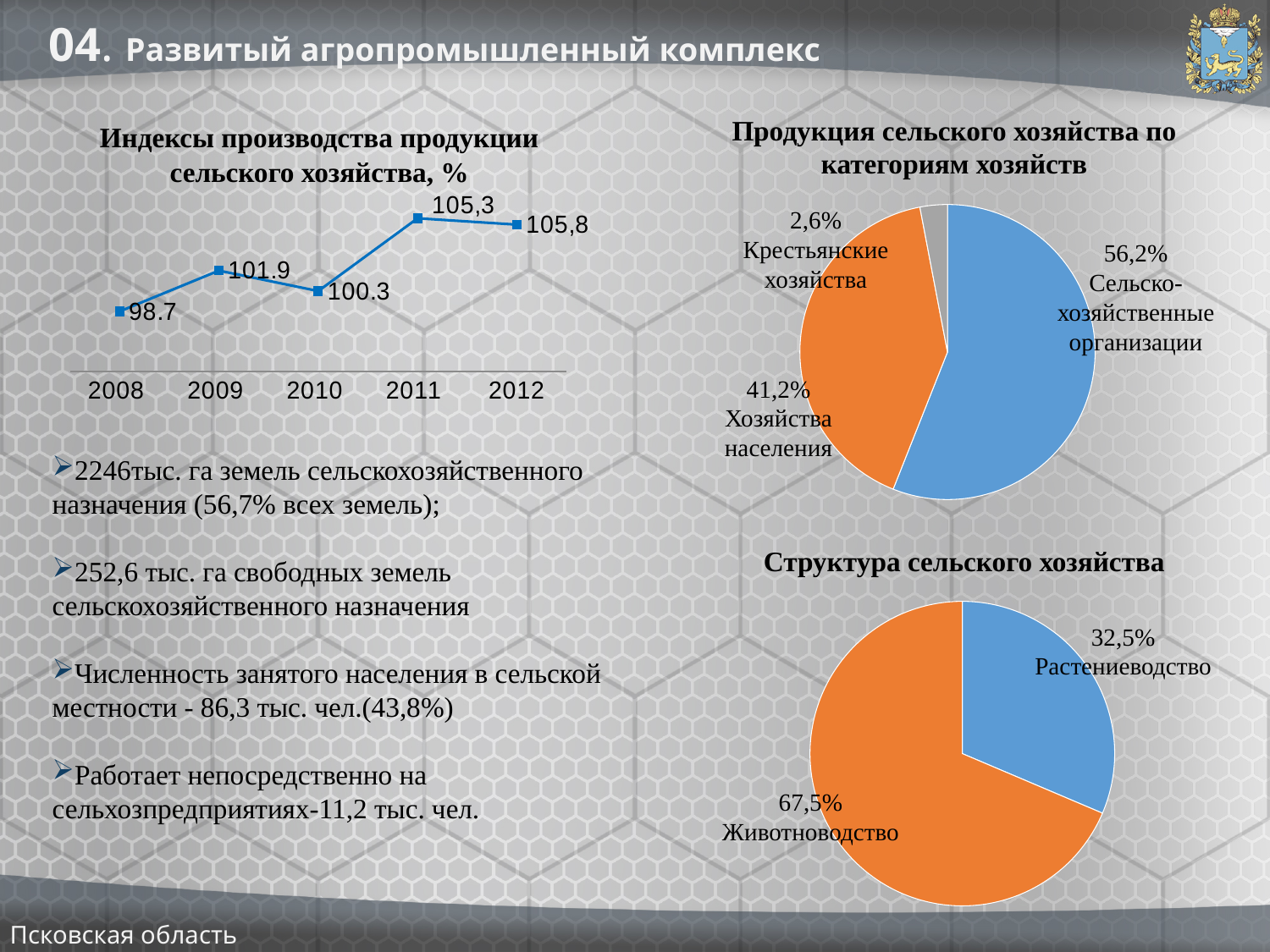
In the pie chart 'Продукция сельского хозяйства по категориям хозяйств', what share do Хозяйства населения have? 41,2% In the chart 'Индексы производства продукции сельского хозяйства, %', what is the value for 2012? 105,8 In the chart 'Индексы производства продукции сельского хозяйства, %', how many years are plotted? 5 In the pie chart 'Структура сельского хозяйства', what share does Животноводство have? 67,5% In the chart 'Индексы производства продукции сельского хозяйства, %', what is the value for 2008? 98.7 In the pie chart 'Продукция сельского хозяйства по категориям хозяйств', how many categories are shown? 3 In the pie chart 'Структура сельского хозяйства', what is the difference between the shares of Животноводство and Растениеводство? 35 percentage points In the chart 'Индексы производства продукции сельского хозяйства, %', is the value for 2009 larger or smaller than the value for 2010? larger What kind of chart is 'Индексы производства продукции сельского хозяйства, %'? line chart In the chart 'Индексы производства продукции сельского хозяйства, %', which year has the lowest value? 2008 In the pie chart 'Продукция сельского хозяйства по категориям хозяйств', which category has the smallest share? Крестьянские хозяйства